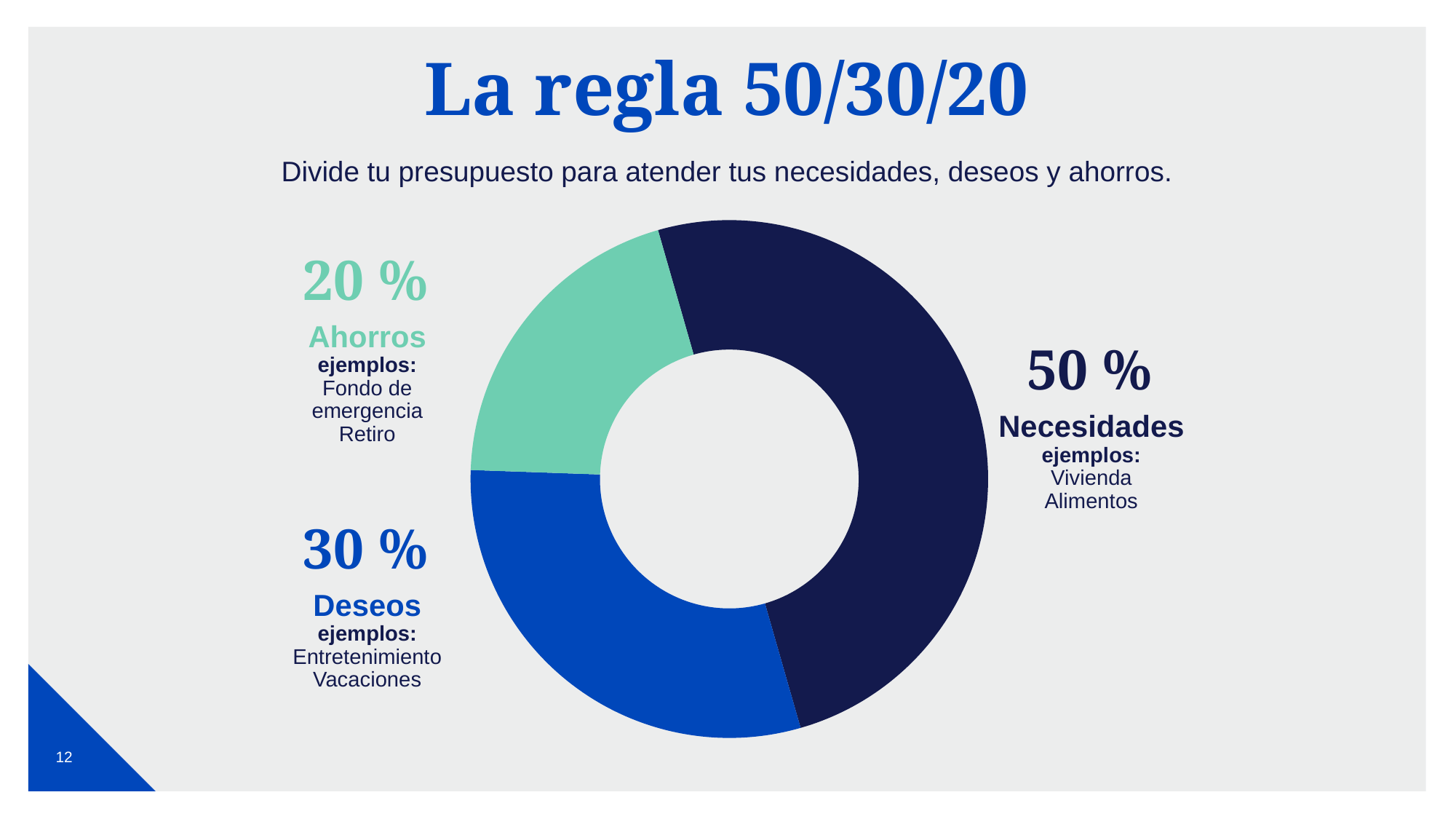
What is the title of the slide containing the chart? La regla 50/30/20 What is the difference between the shares for Necesidades and Ahorros? 30 % What share of the budget is allocated to Deseos? 30 % What kind of chart is shown on the slide? Pie chart (donut) What share of the budget is allocated to Necesidades? 50 % What colour is the slice representing Ahorros? Light green Which category has the smallest share of the budget? Ahorros What is the difference between the shares for Deseos and Ahorros? 10 % What share of the budget is allocated to Ahorros? 20 % Which category has the largest share of the budget? Necesidades Which is larger, the share for Deseos or the share for Ahorros? Deseos How many categories does the chart divide the budget into? 3